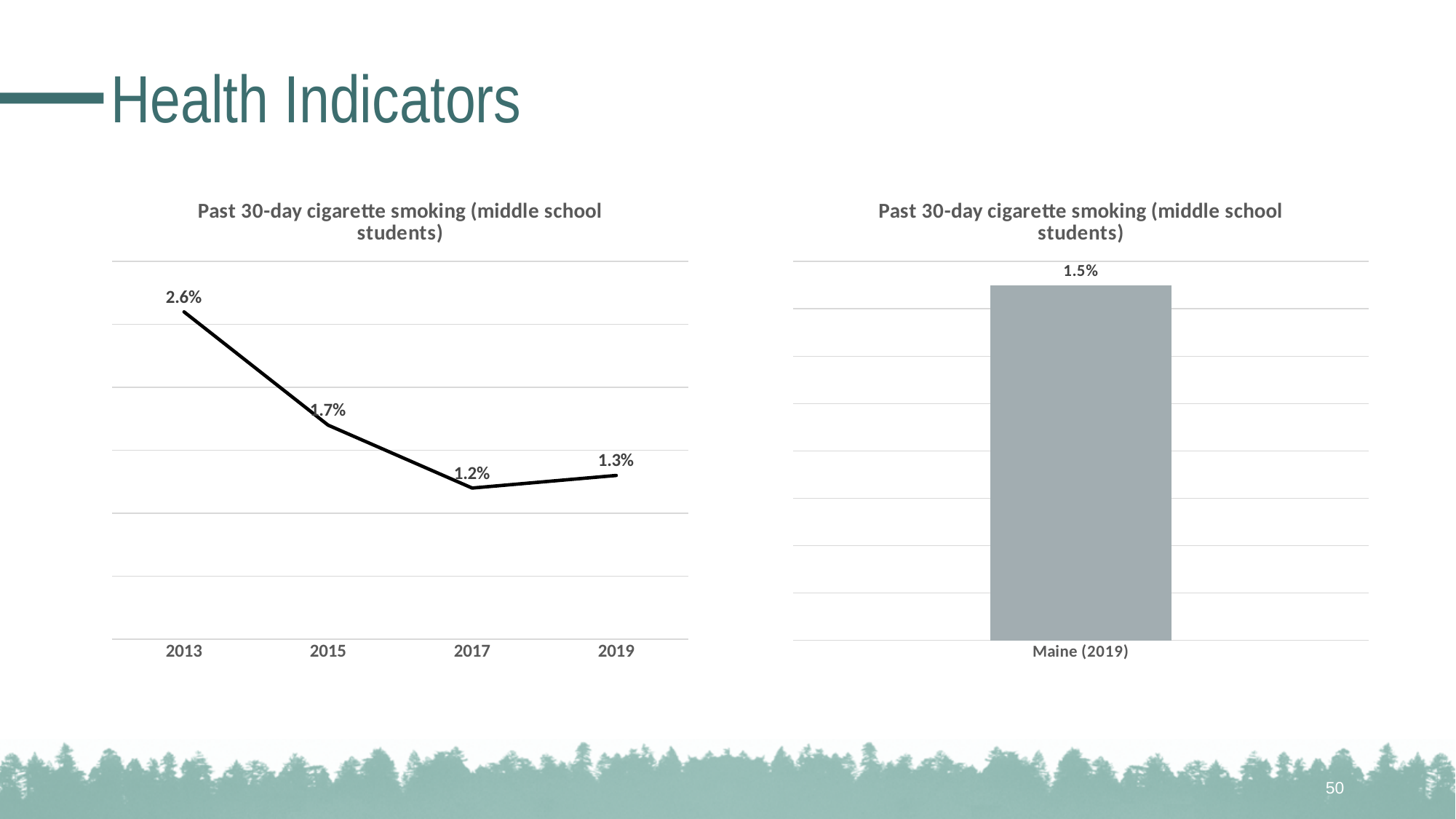
In the left chart, what is the value for 2013? 2.6% In the left chart, what is the difference between the 2013 and 2015 values? 0.9% In the left chart, do the values rise or fall from 2013 to 2017? fall In the left chart, what is the value for 2017? 1.2% In the left chart, which year has the highest value? 2013 What kind of chart is the right chart? bar chart How many data points are plotted in the left chart? 4 In the left chart, what is the value for 2019? 1.3% In the left chart, which year has the lowest value? 2017 Which is larger: the 2019 value in the left chart or the Maine (2019) value in the right chart? Maine (2019) What kind of chart is the left chart? line chart In the right chart, what is the value for Maine (2019)? 1.5%